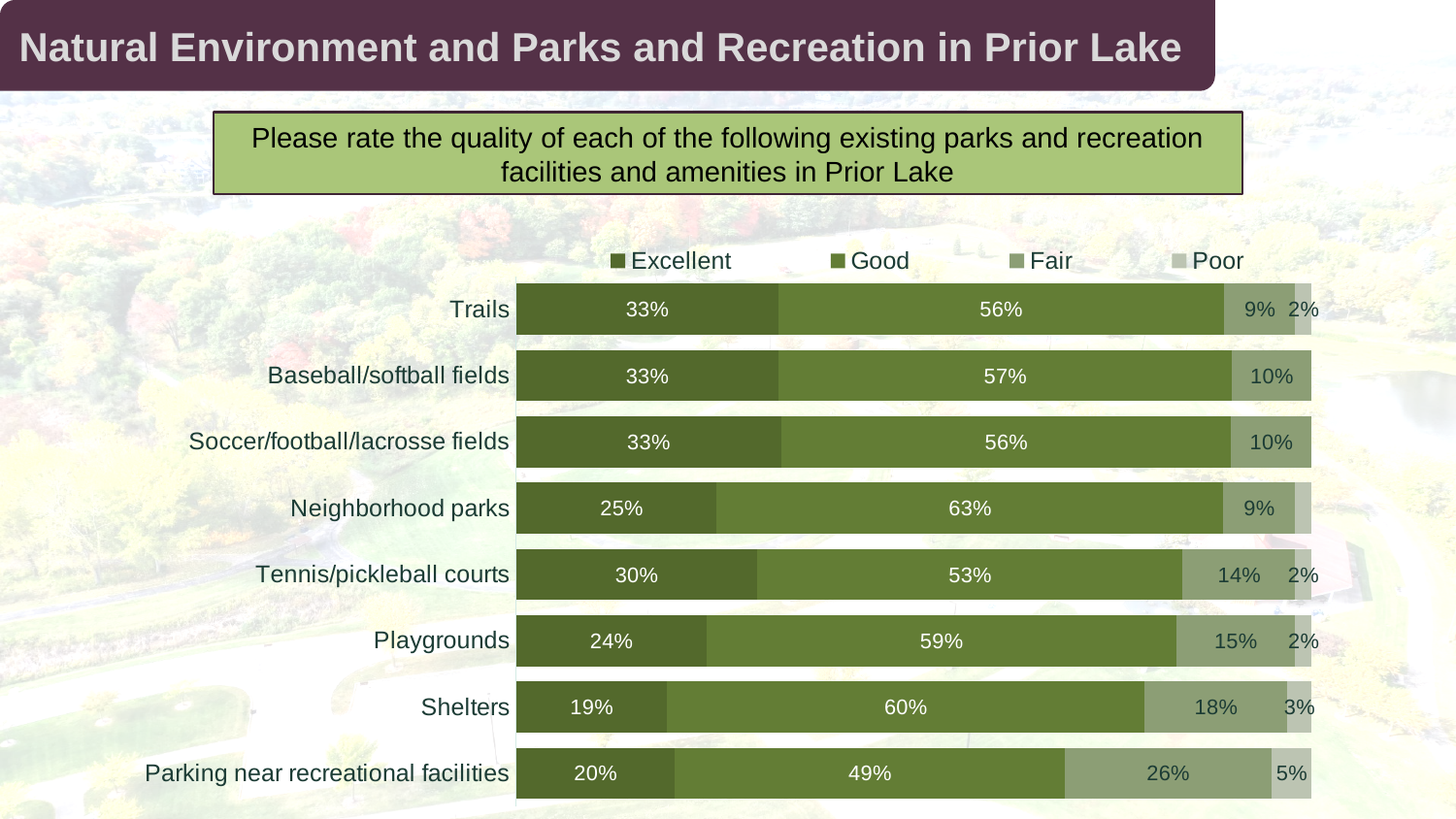
What percentage rated Shelters as Poor? 3% How many facilities are rated in the chart? 8 What kind of chart is shown on the slide? Stacked bar chart Which has a larger Fair rating, Parking near recreational facilities or Shelters? Parking near recreational facilities What percentage rated Neighborhood parks as Excellent? 25% What percentage rated Parking near recreational facilities as Fair? 26% Which facility has the highest Good rating? Neighborhood parks What percentage rated Trails as Good? 56% What is the difference in percentage points between the Good rating for Neighborhood parks and the Good rating for Parking near recreational facilities? 14 How many rating categories does the legend list? 4 What is the total of the four labelled segments for Trails? 100% Which facility has the lowest Excellent rating? Shelters